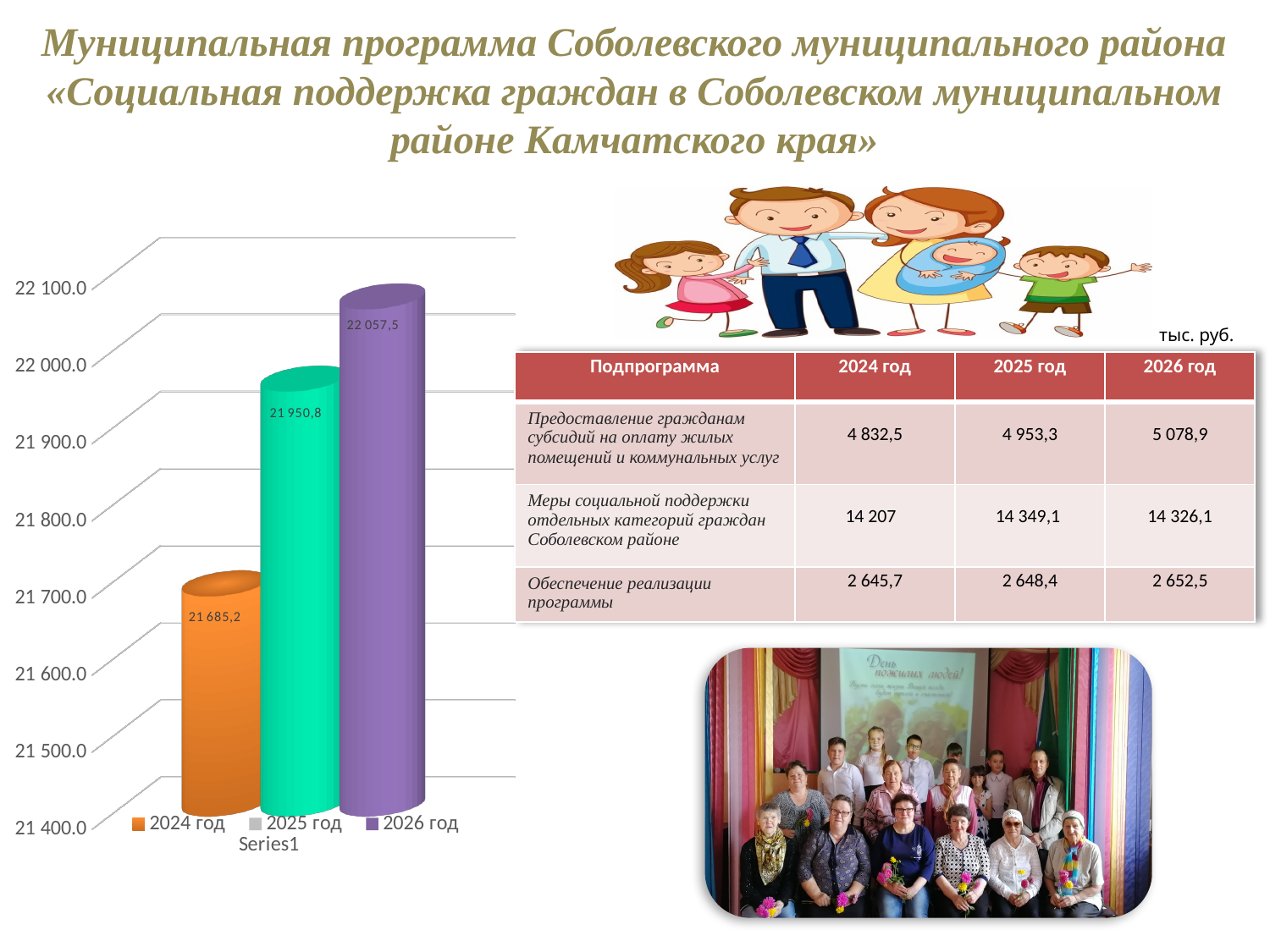
What is the difference between the values for 2025 год and 2024 год on the chart? 265,6 What is the value shown for 2024 год on the chart? 21 685,2 Which year has the highest value on the chart? 2026 год Is the value for 2024 год on the chart greater or less than 21 600? greater How many bars are plotted on the chart? 3 What kind of chart is shown on the slide? bar chart What is the value shown for 2025 год on the chart? 21 950,8 Which year has the lowest value on the chart? 2024 год What is the value shown for 2026 год on the chart? 22 057,5 How many series does the chart legend list? 3 What is the difference between the values for 2026 год and 2025 год on the chart? 106,7 Which is larger on the chart, the value for 2024 год or the value for 2025 год? 2025 год